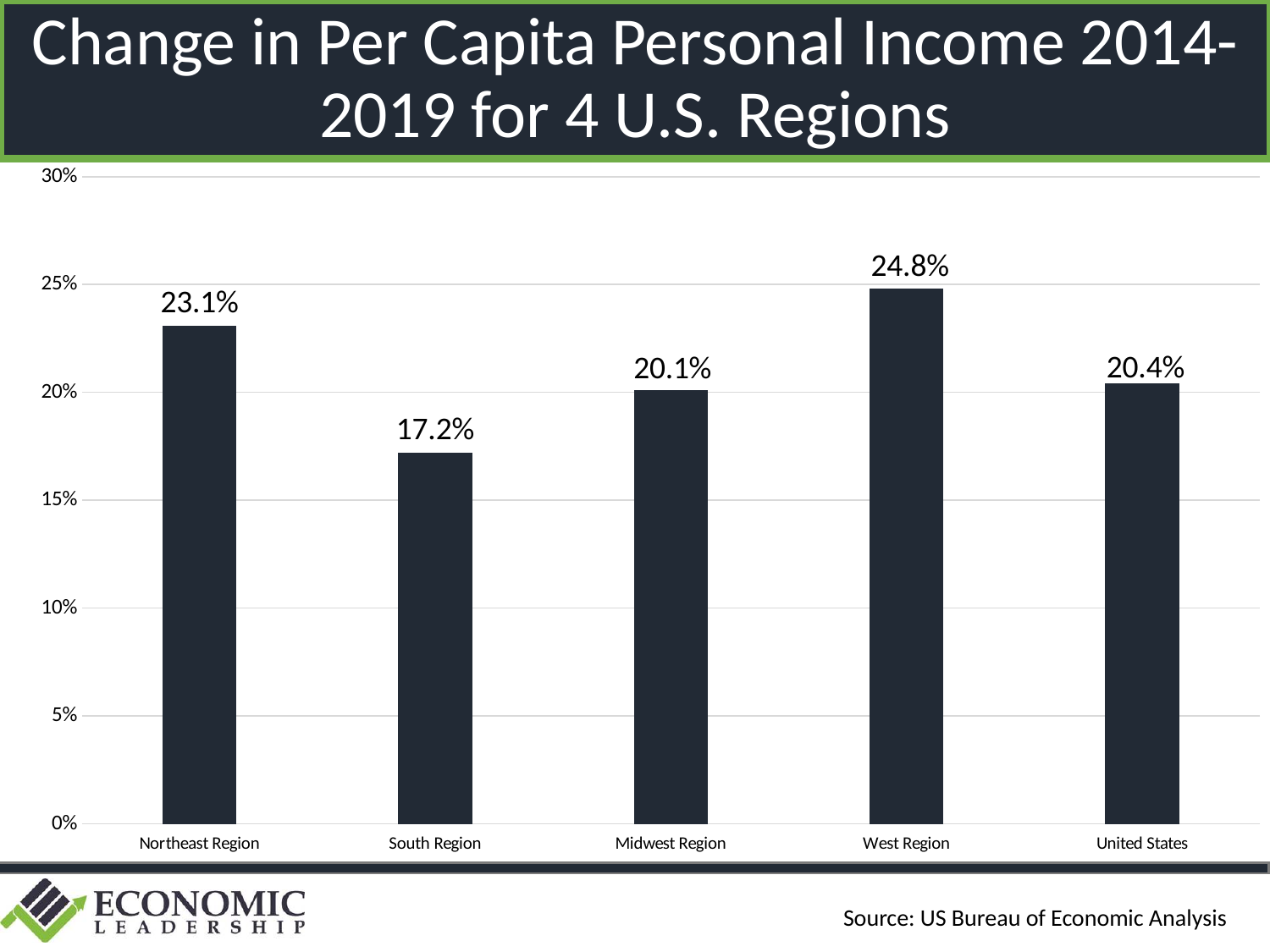
What is the value shown for the United States? 20.4% Is the value for the South Region greater or less than 20%? less What is the change in per capita personal income for the South Region? 17.2% Which is larger, the value for the Midwest Region or the Northeast Region? Northeast Region What source is cited for the chart data? US Bureau of Economic Analysis Which region has the lowest change in per capita personal income? South Region What is the difference between the Northeast Region and the United States values? 2.7% What is the difference between the West Region and the South Region values? 7.6% What kind of chart is shown on the slide? Bar chart Which region has the highest change in per capita personal income? West Region What is the change in per capita personal income for the Northeast Region? 23.1% How many bars are shown in the chart? 5